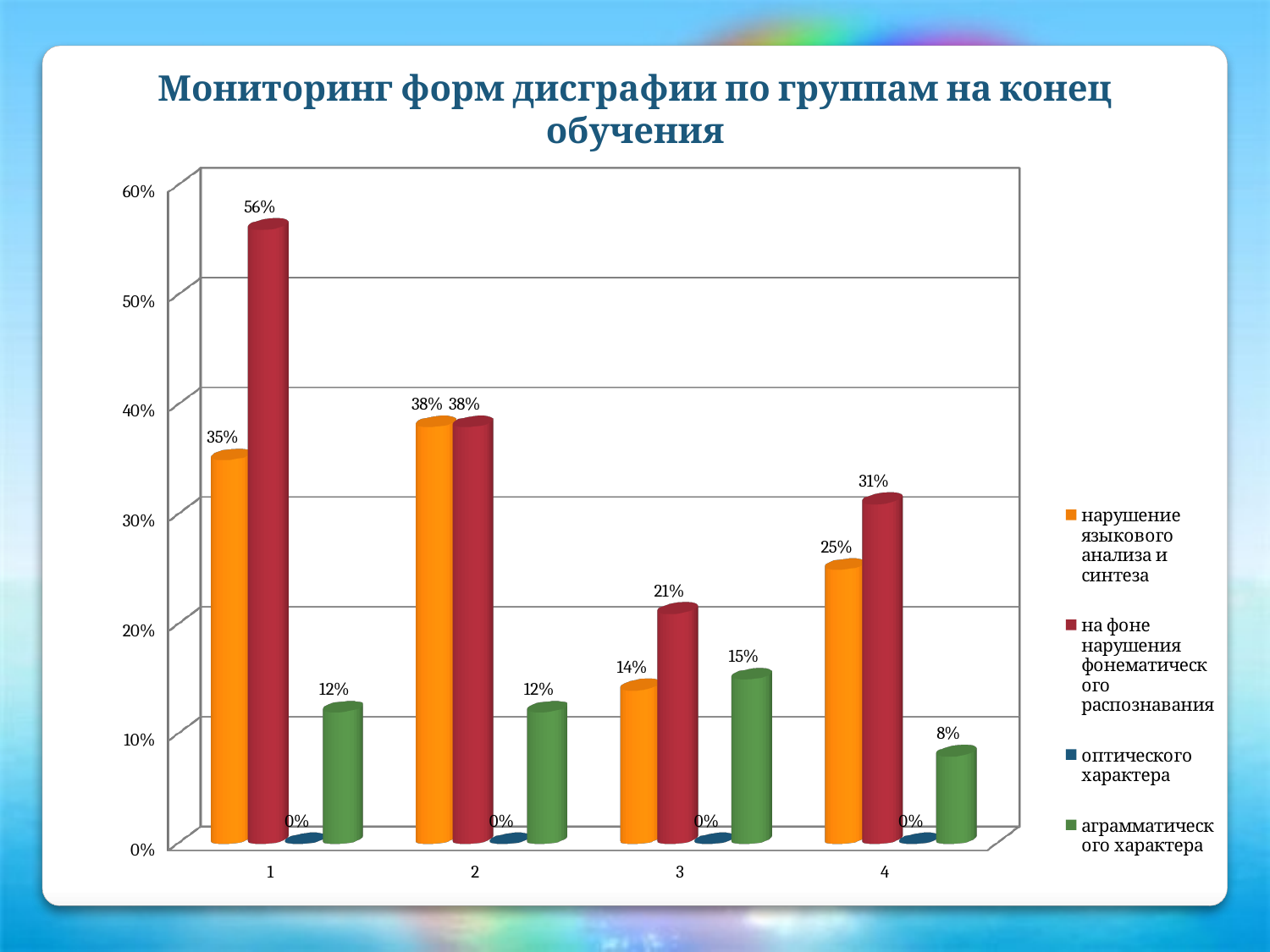
What is the value for 'нарушение языкового анализа и синтеза' in group 4? 25% How many series does the legend list? 4 What is the value for 'аграмматического характера' in group 3? 15% What is the value for 'на фоне нарушения фонематического распознавания' in group 1? 56% What is the title of the chart? Мониторинг форм дисграфии по группам на конец обучения What is the difference between the 'на фоне нарушения фонематического распознавания' value and the 'нарушение языкового анализа и синтеза' value in group 1? 21% Which group has the lowest value for 'аграмматического характера'? 4 In group 3, which is larger: 'на фоне нарушения фонематического распознавания' or 'нарушение языкового анализа и синтеза'? на фоне нарушения фонематического распознавания What kind of chart is shown on the slide? bar chart How many groups are shown on the x axis? 4 What is the value for 'оптического характера' in group 2? 0% Which group has the highest value for 'на фоне нарушения фонематического распознавания'? 1